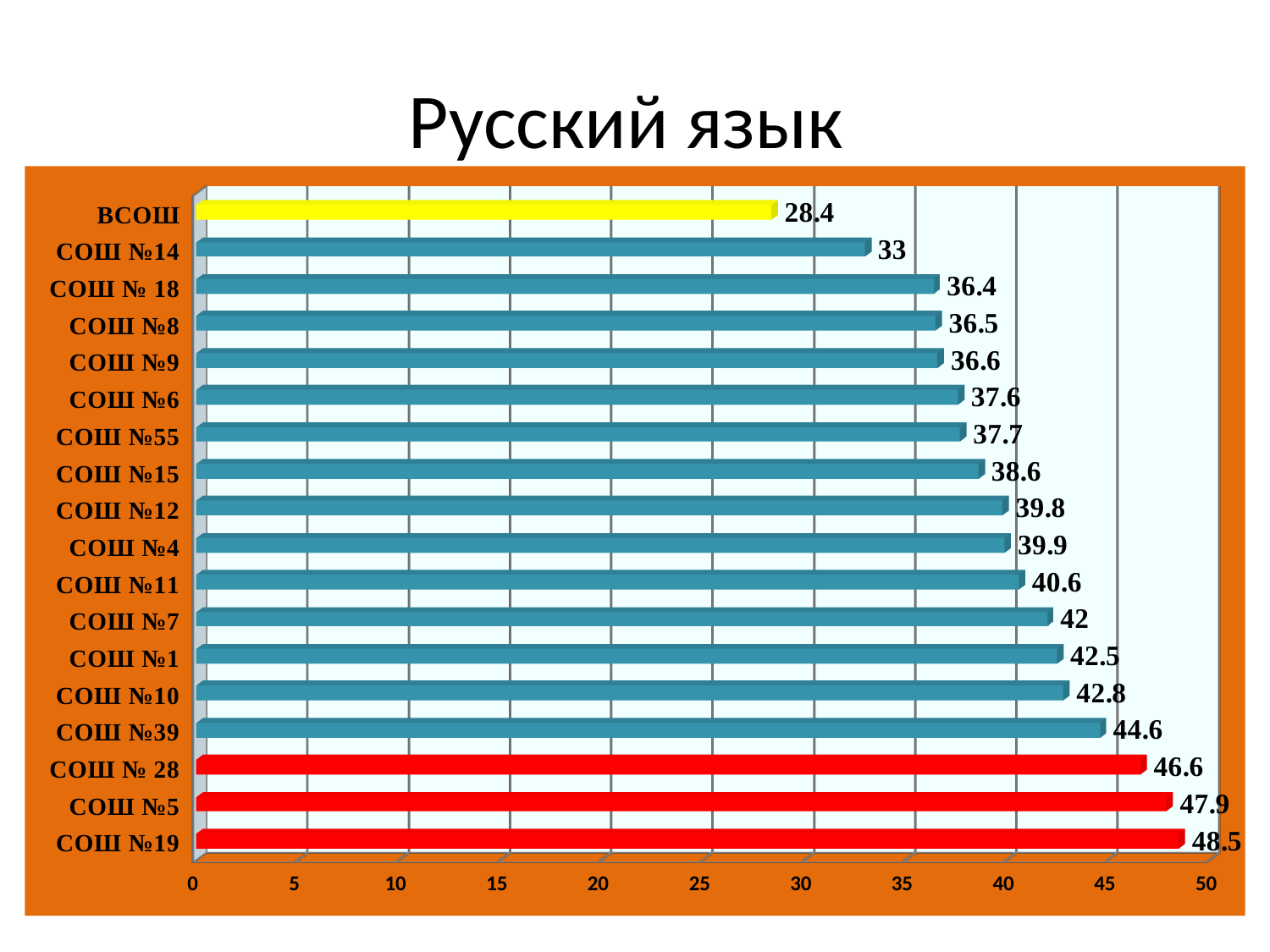
What is the title of the slide? Русский язык What is the value for СОШ №11? 40.6 How many categories are shown in the chart? 18 What is the difference between the values for СОШ №19 and ВСОШ? 20.1 Which is larger, the value for СОШ №5 or the value for СОШ №7? СОШ №5 Which category has the highest value? СОШ №19 Which category has the lowest value? ВСОШ Is the value for СОШ №10 greater or less than 40? greater What kind of chart is shown on the slide? bar chart What is the difference between the values for СОШ №39 and СОШ №14? 11.6 What is the value for ВСОШ? 28.4 What is the value for СОШ №19? 48.5